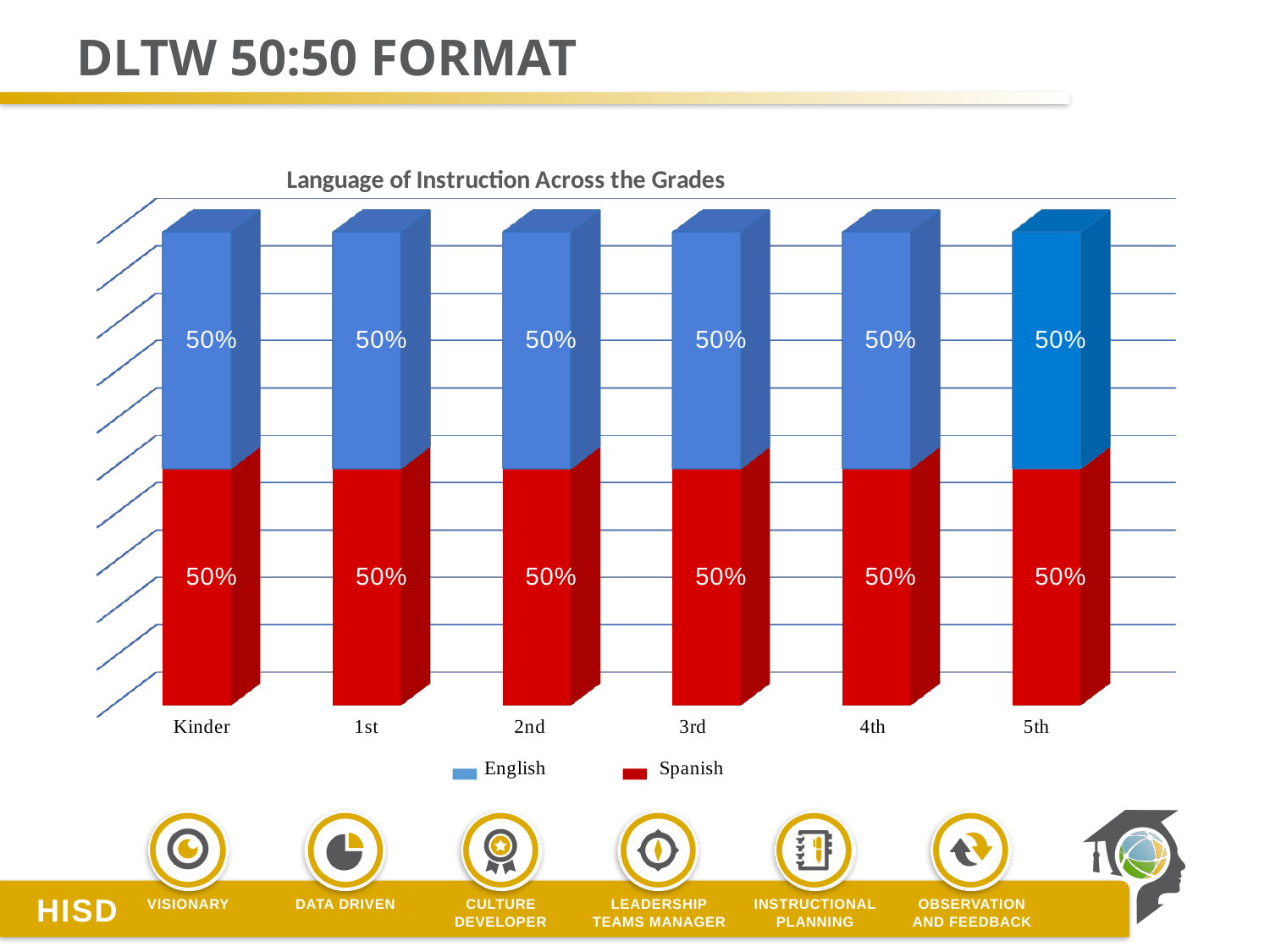
Does the English share rise, fall, or stay the same from Kinder to 5th grade? stays the same How many series does the chart legend list? 2 What type of chart is shown on the slide? stacked bar chart Which colour represents Spanish in the chart? red How many grade categories are shown along the x axis of the chart? 6 What is the English value for 5th grade? 50% What percentage of instruction is in Spanish for 3rd grade? 50% What is the total of the stacked bar for 2nd grade? 100% What percentage of instruction is in English for Kinder? 50% What is the difference between the English and Spanish values for 4th grade? 0% What is the title of the chart? Language of Instruction Across the Grades What is the Spanish value for 1st grade? 50%